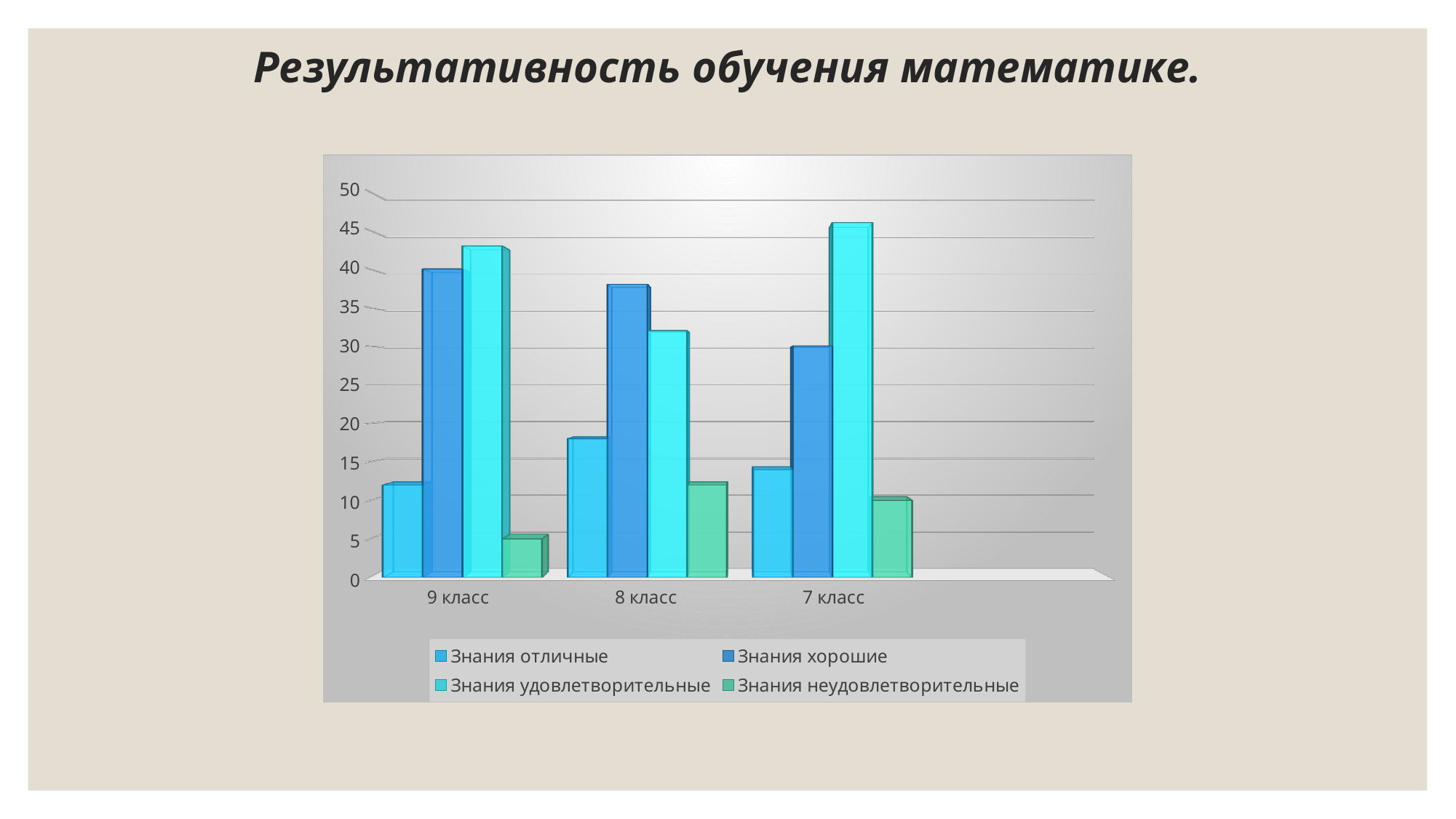
What kind of chart is shown on the slide? bar chart Which class has the highest value for Знания отличные? 8 класс How many series does the legend list? 4 Which class has the highest value for Знания хорошие? 9 класс Which class has the highest value for Знания удовлетворительные? 7 класс How many categories (classes) are shown on the x axis? 3 Is the value for Знания удовлетворительные in 7 класс greater or less than 40? greater Which class has the lowest value for Знания неудовлетворительные? 9 класс Is the value for Знания хорошие in 9 класс greater or less than 35? greater Is the value for Знания неудовлетворительные in 9 класс greater or less than 10? less What is the title of the slide? Результативность обучения математике. In 8 класс, which is larger: Знания хорошие or Знания удовлетворительные? Знания хорошие